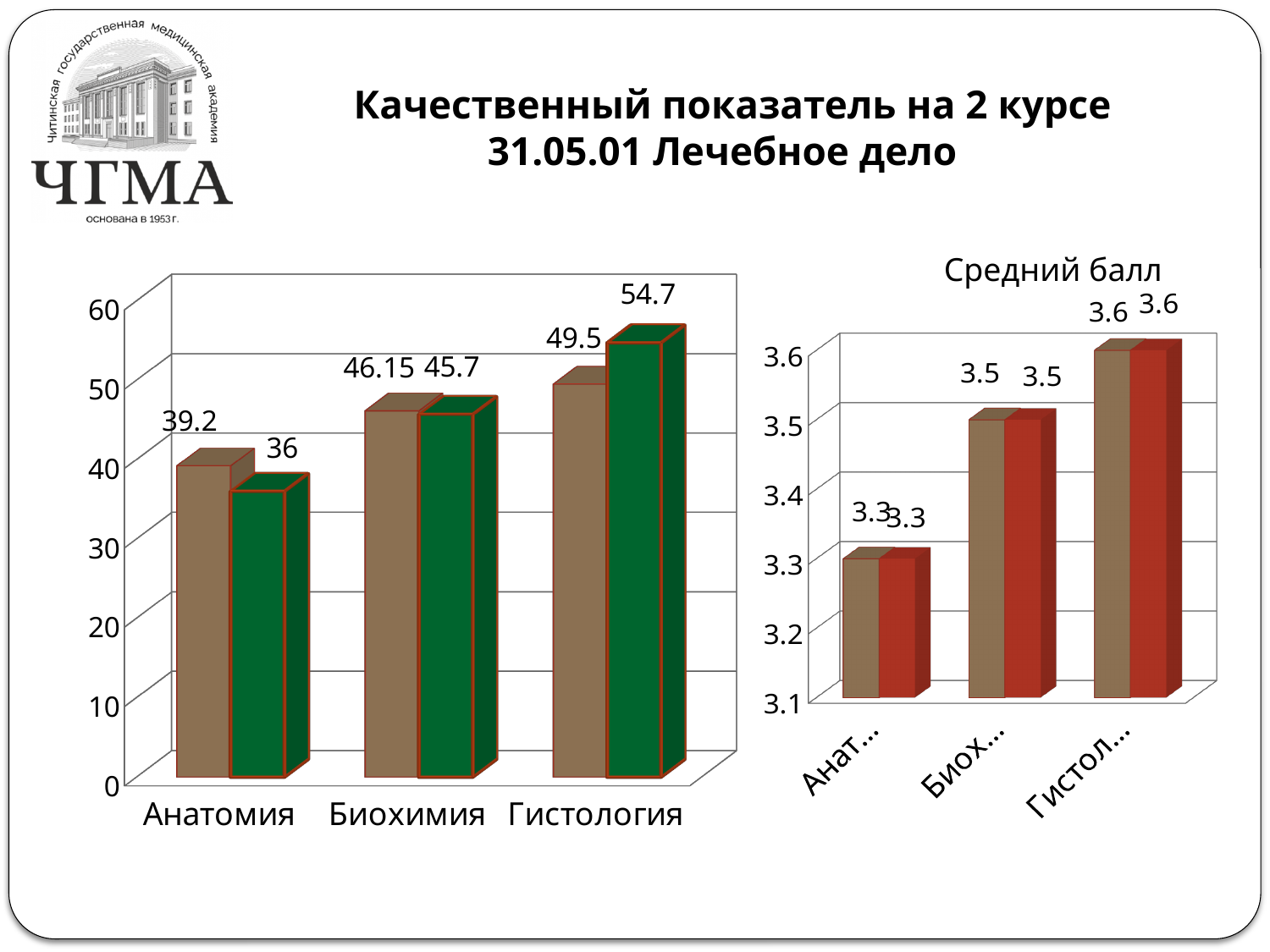
In the left chart, how many categories are shown on the x axis? 3 In the left chart, which category has the lowest brown bar? Анатомия In the chart titled 'Средний балл', what is the value of the third (rightmost) category's bars? 3.6 In the left chart, what is the value of the green bar for Гистология? 54.7 In the left chart, what is the difference between the green bar for Гистология (54.7) and the brown bar for Гистология (49.5)? 5.2 In the chart titled 'Средний балл', what is the value of the first (leftmost) category's bars? 3.3 In the left chart, which is larger for Анатомия: the brown bar or the green bar? the brown bar In the left chart, what is the value of the brown bar for Биохимия? 46.15 In the left chart, which category has the highest green bar? Гистология In the chart titled 'Средний балл', do the values rise or fall from left to right along the x axis? rise In the left chart, what is the value of the brown bar for Анатомия? 39.2 What type of chart is the left chart? bar chart